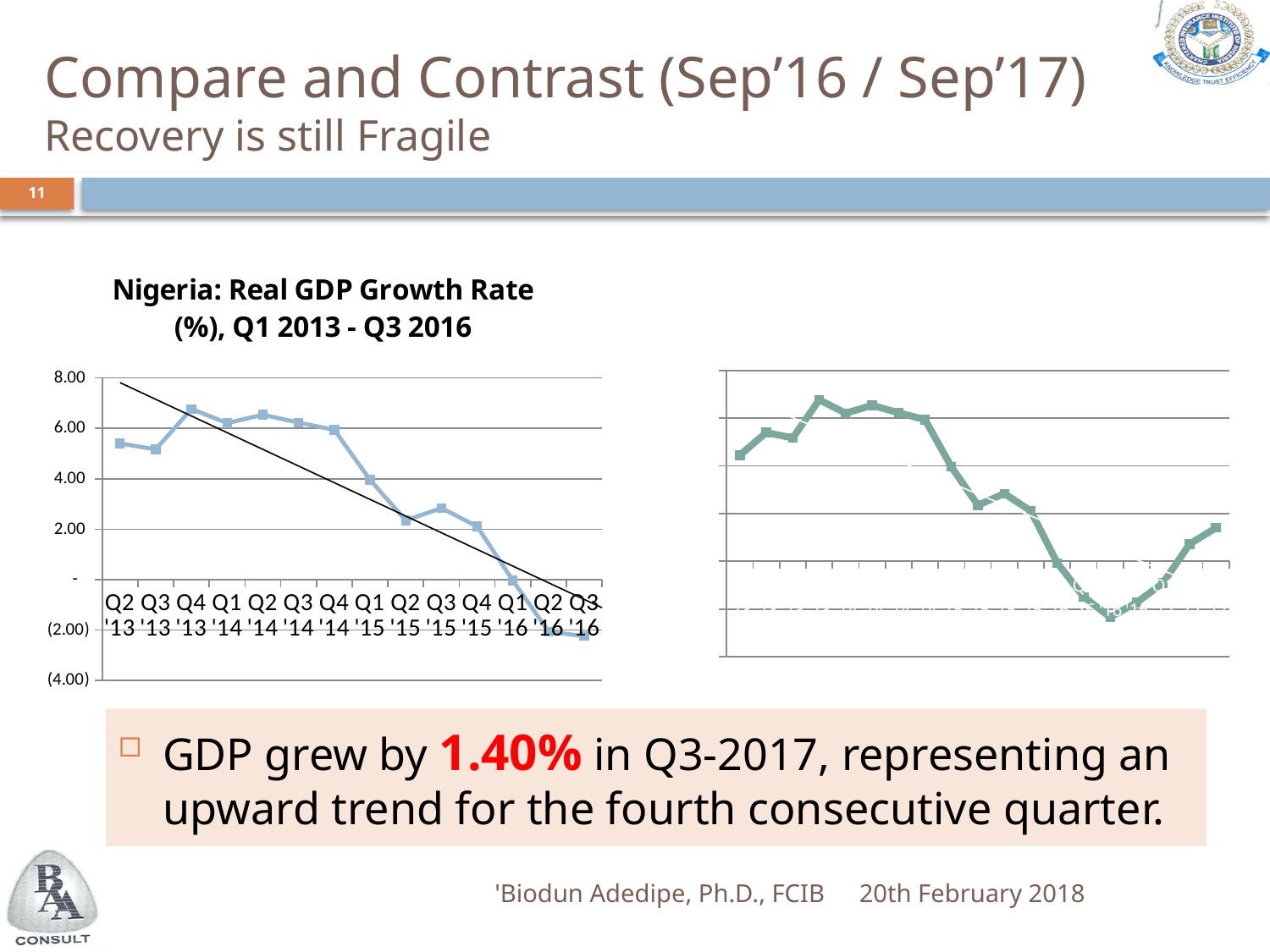
What kind of chart is the chart on the right side of the slide? Line chart What kind of chart is the left chart titled 'Nigeria: Real GDP Growth Rate (%), Q1 2013 - Q3 2016'? Line chart In the left chart 'Nigeria: Real GDP Growth Rate', how many quarters are labelled on the x axis? 14 In the left chart 'Nigeria: Real GDP Growth Rate', which is larger, the value for Q3 '15 or the value for Q2 '16? Q3 '15 In the left chart 'Nigeria: Real GDP Growth Rate', which quarter has the lowest value? Q3 '16 What is the title of the left chart on the slide? Nigeria: Real GDP Growth Rate (%), Q1 2013 - Q3 2016 In the left chart 'Nigeria: Real GDP Growth Rate', do the values generally rise or fall from Q2 '13 to Q3 '16? Fall In the left chart 'Nigeria: Real GDP Growth Rate', is the value for Q2 '13 greater or less than 4.00? greater In the left chart 'Nigeria: Real GDP Growth Rate', which is larger, the value for Q4 '13 or the value for Q1 '15? Q4 '13 In the left chart 'Nigeria: Real GDP Growth Rate', is the value for Q1 '15 greater or less than 2.00? greater In the left chart 'Nigeria: Real GDP Growth Rate', is the value for Q4 '13 greater or less than 6.00? greater